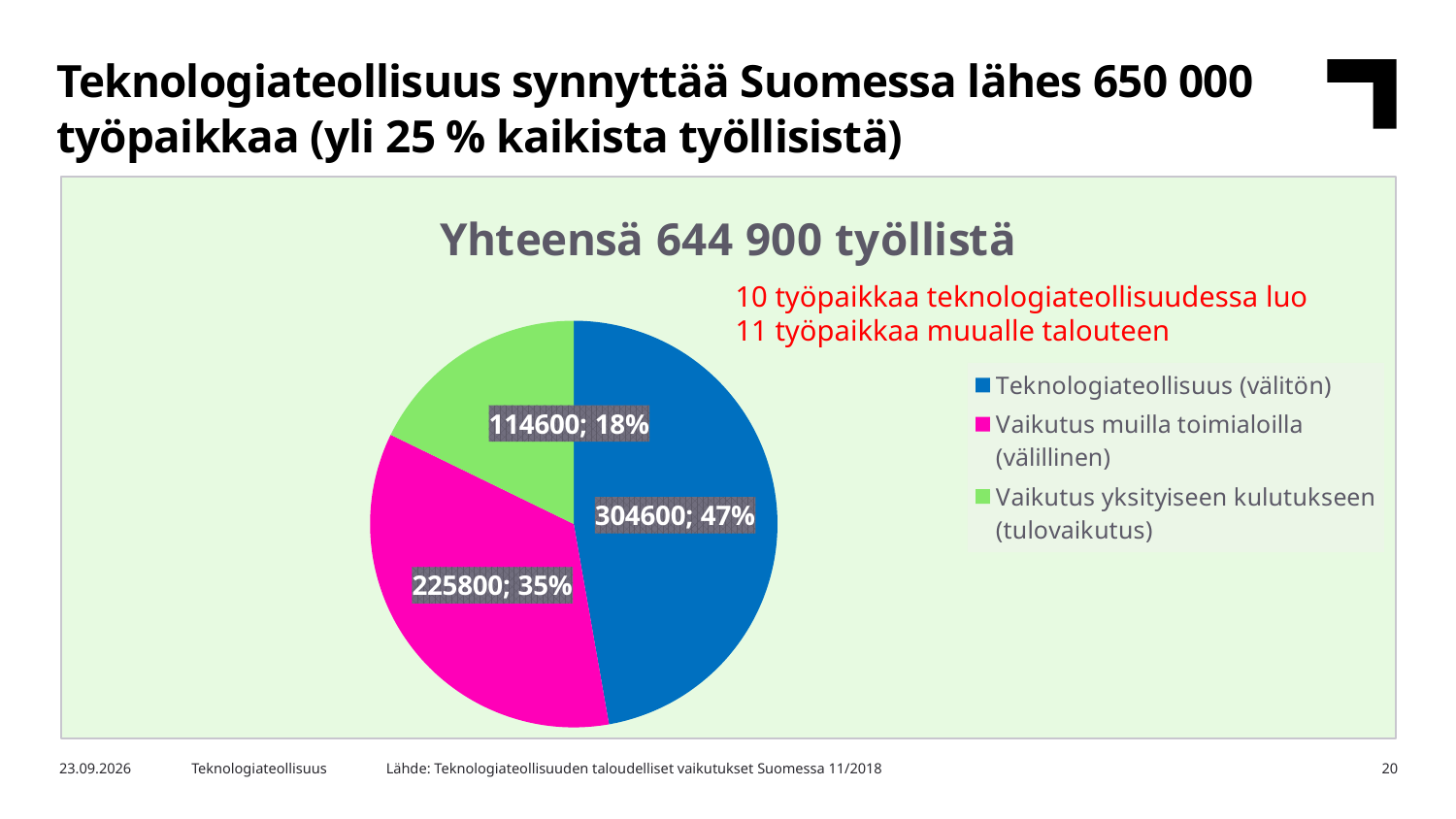
What type of chart is shown on the slide? pie chart How many slices does the pie chart have? 3 Which category has the largest slice of the pie? Teknologiateollisuus (välitön) What share of the pie does Teknologiateollisuus (välitön) represent? 47% What is the difference between the values for Teknologiateollisuus (välitön) and Vaikutus muilla toimialoilla (välillinen)? 78800 What is the title of the chart? Yhteensä 644 900 työllistä What share of the pie does Vaikutus yksityiseen kulutukseen (tulovaikutus) represent? 18% Which category has the smallest slice of the pie? Vaikutus yksityiseen kulutukseen (tulovaikutus) What is the value for Vaikutus yksityiseen kulutukseen (tulovaikutus)? 114600 What is the value for Teknologiateollisuus (välitön)? 304600 What is the value for Vaikutus muilla toimialoilla (välillinen)? 225800 Which is larger: the value for Vaikutus muilla toimialoilla (välillinen) or Vaikutus yksityiseen kulutukseen (tulovaikutus)? Vaikutus muilla toimialoilla (välillinen)